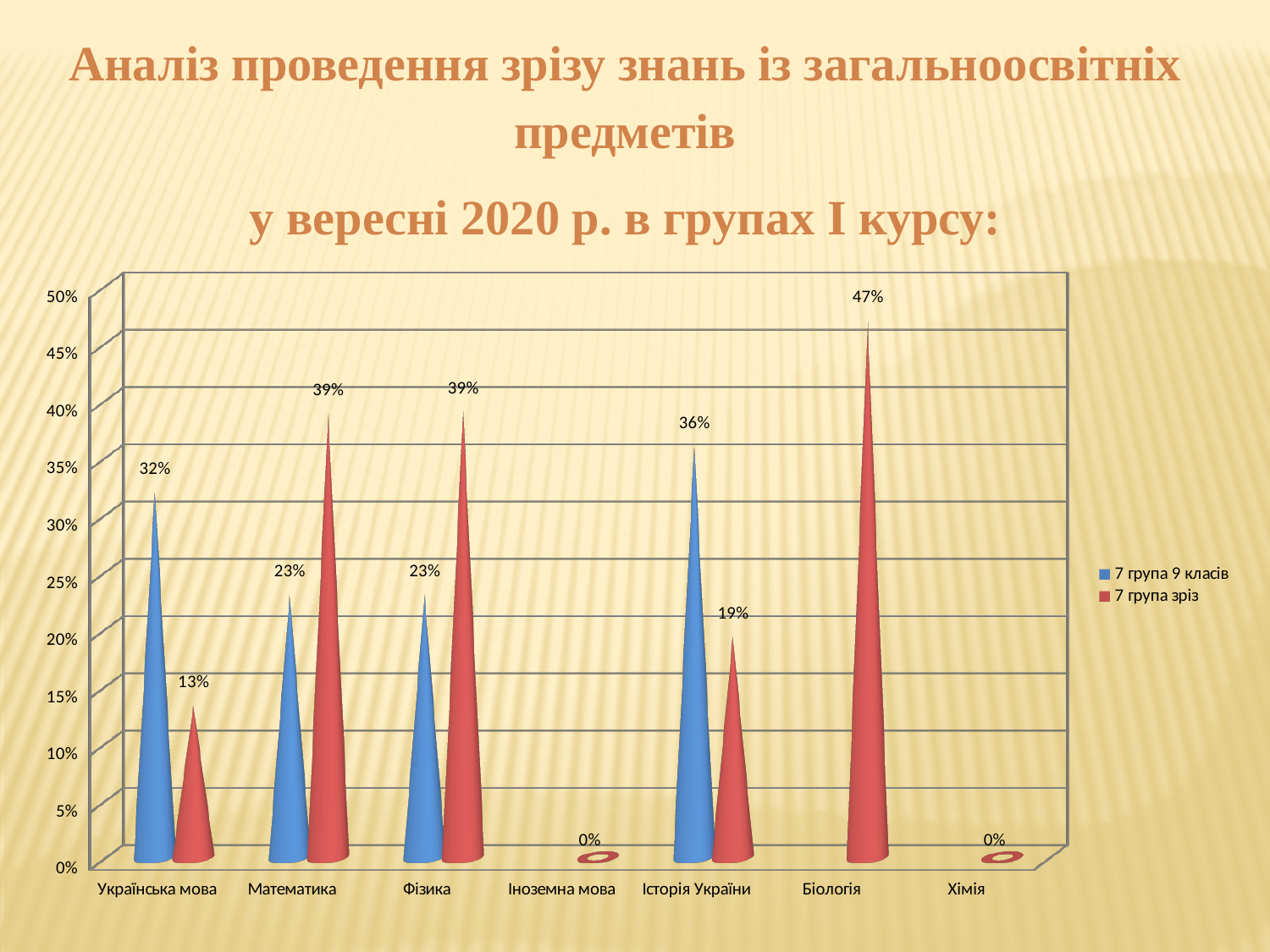
What is the value for Українська мова in the 7 група 9 класів series? 32% Which category has the highest value in the 7 група 9 класів series? Історія України What kind of chart is shown on the slide? Bar chart How many categories are shown on the x axis? 7 For Українська мова, which series has the larger value: 7 група 9 класів or 7 група зріз? 7 група 9 класів What is the value for Біологія in the 7 група зріз series? 47% What is the value for Історія України in the 7 група зріз series? 19% What is the value for Математика in the 7 група 9 класів series? 23% How many series does the legend list? 2 What is the difference between the 7 група зріз and 7 група 9 класів values for Математика? 16% Which category has the highest value in the 7 група зріз series? Біологія Which colour represents the 7 група зріз series? Red